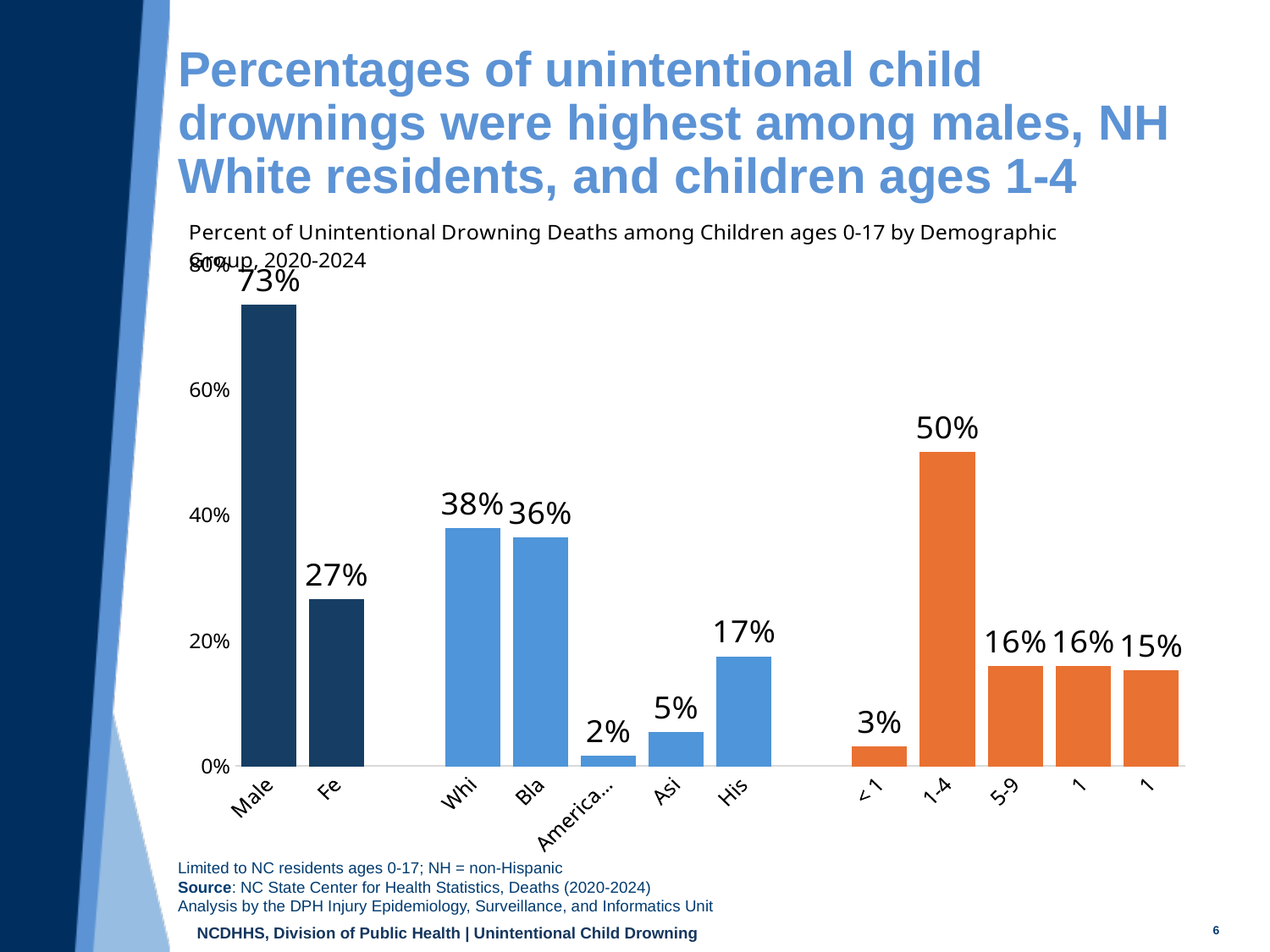
What is the difference between the values for Male and the 1-4 age group? 23% Is the value for the <1 age group greater or less than 20%? less What is the value for the <1 age group? 3% Which is larger, the value for the 1-4 age group or the value for the 5-9 age group? 1-4 What is the value for Male? 73% What is the difference between the values for the 1-4 and 5-9 age groups? 34% What is the lowest value shown on the chart? 2% What is the value for the 1-4 age group? 50% Which category has the highest value? Male What is the value for the 5-9 age group? 16% Is the value for Male greater or less than 60%? greater What kind of chart is shown? bar chart